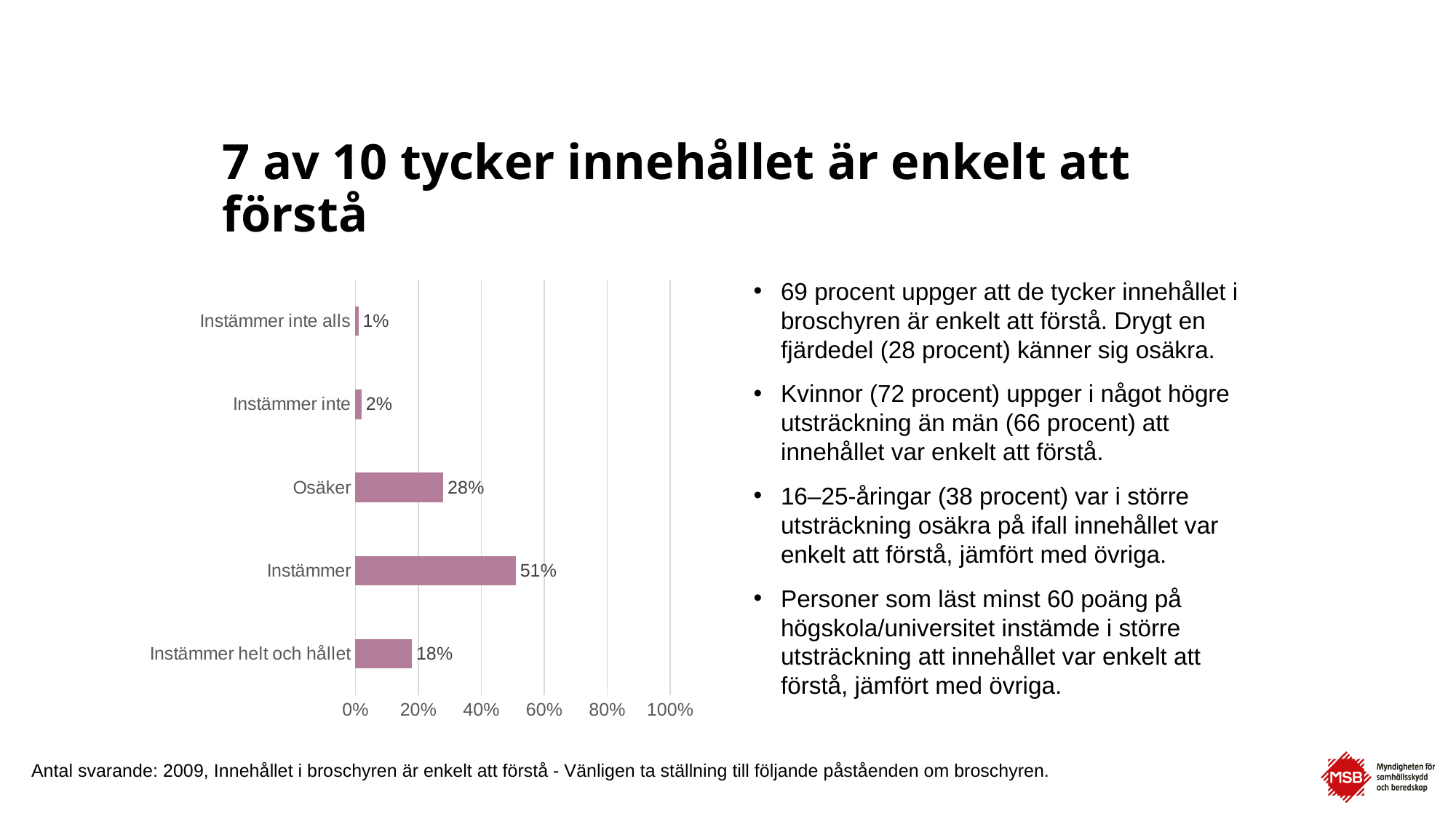
What is the difference between the values for Instämmer and Osäker? 23% Which category has the lowest value? Instämmer inte alls What is the combined value of Instämmer and Instämmer helt och hållet? 69% What is the value for Instämmer inte alls? 1% What is the value for Osäker? 28% What is the value for Instämmer? 51% Which is larger, the value for Osäker or the value for Instämmer helt och hållet? Osäker Is the value for Instämmer greater or less than 40%? greater Which category has the highest value? Instämmer What kind of chart is shown on the slide? bar chart How many categories are shown in the chart? 5 What is the value for Instämmer helt och hållet? 18%